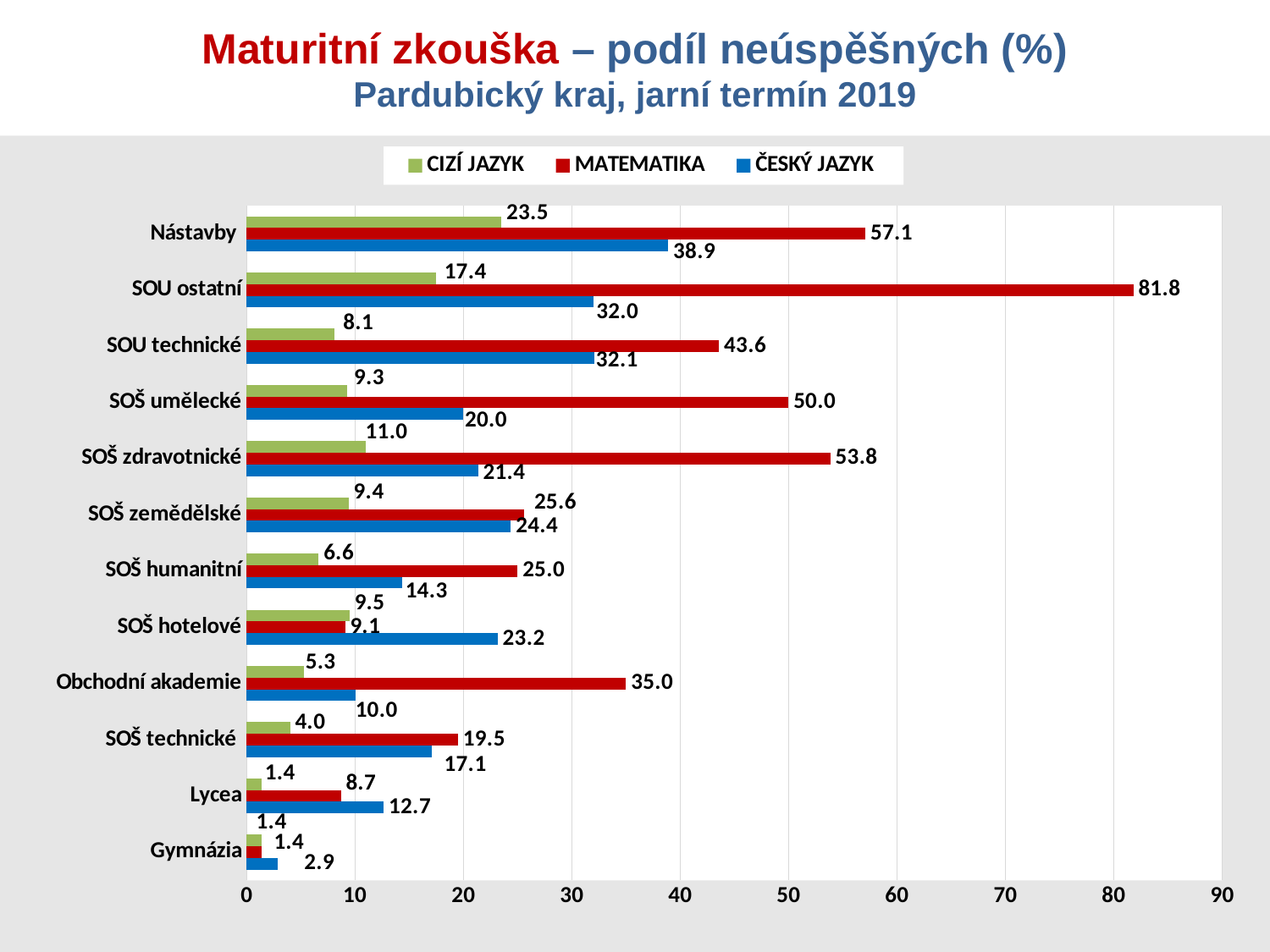
What is the difference between the MATEMATIKA and ČESKÝ JAZYK values for Nástavby? 18.2 What kind of chart is shown on the slide? Bar chart What is the MATEMATIKA value for SOU ostatní? 81.8 Is the MATEMATIKA value for SOŠ zdravotnické greater or less than 50? greater Which category has the highest MATEMATIKA value? SOU ostatní Which category has the lowest ČESKÝ JAZYK value? Gymnázia How many series does the legend list? 3 Which series is shown in red? MATEMATIKA What is the CIZÍ JAZYK value for Obchodní akademie? 5.3 What is the ČESKÝ JAZYK value for Nástavby? 38.9 How many categories are shown on the chart? 12 For SOŠ hotelové, which is larger: the ČESKÝ JAZYK value or the MATEMATIKA value? ČESKÝ JAZYK